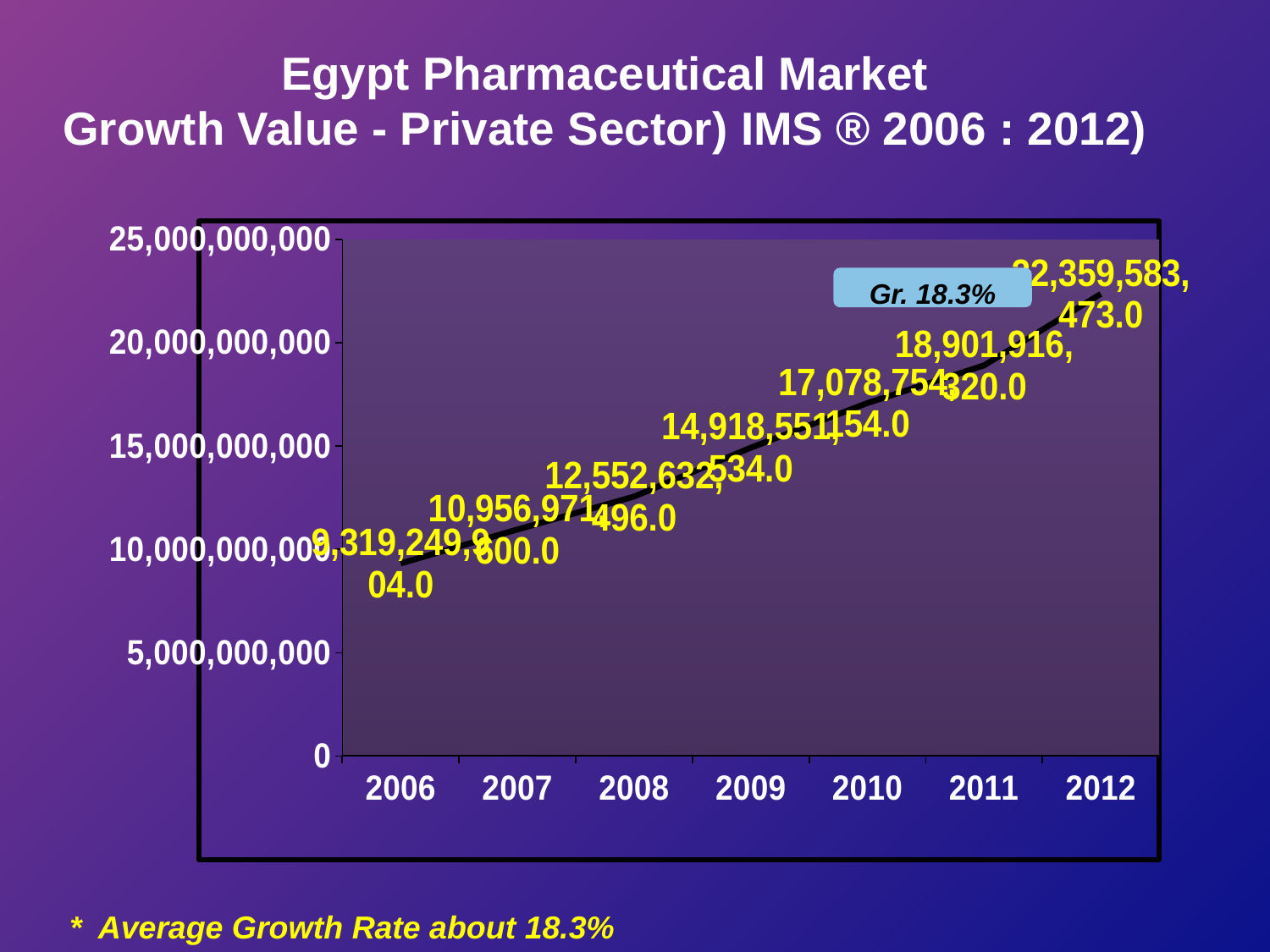
Which is larger, the value for 2011 or the value for 2009? 2011 Which year has the highest value? 2012 What is the value for 2010? 17,078,754,154.0 Which year has the lowest value? 2006 How many years are plotted on the x axis? 7 Do the values rise or fall from 2006 to 2012? rise What average growth rate is shown in the box on the chart? Gr. 18.3% Is the value for 2006 greater or less than 10,000,000,000? less What is the value for 2009? 14,918,551,534.0 Is the value for 2012 greater or less than 20,000,000,000? greater What kind of chart is shown on the slide? line chart What is the value for 2008? 12,552,632,496.0